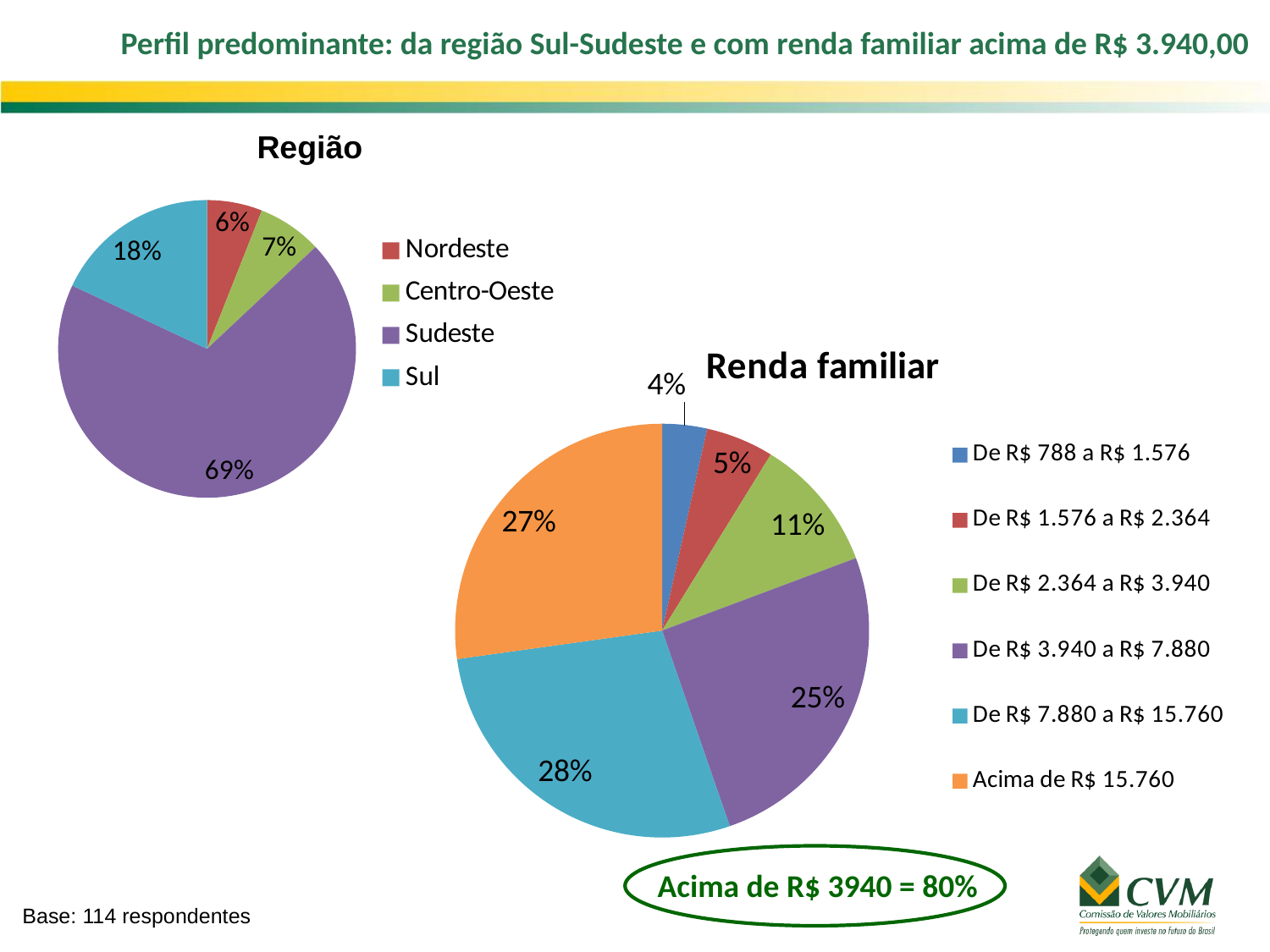
In the 'Renda familiar' pie chart, how many income brackets does the legend list? 6 In the 'Região' pie chart, what is the difference between the shares of Sudeste and Sul? 51% In the 'Renda familiar' pie chart, what is the share for 'De R$ 7.880 a R$ 15.760'? 28% In the 'Região' pie chart, what is the share for Sul? 18% What type of chart is the 'Renda familiar' chart? Pie chart In the 'Região' pie chart, which region has the smallest share? Nordeste In the 'Renda familiar' pie chart, which income bracket has the largest share? De R$ 7.880 a R$ 15.760 In the 'Renda familiar' pie chart, which is larger: 'De R$ 2.364 a R$ 3.940' or 'De R$ 3.940 a R$ 7.880'? De R$ 3.940 a R$ 7.880 In the 'Renda familiar' pie chart, what is the share for 'De R$ 788 a R$ 1.576'? 4% In the 'Região' pie chart, what is the share for Sudeste? 69% In the 'Região' pie chart, how many regions are shown? 4 In the 'Renda familiar' pie chart, what is the combined share of 'De R$ 1.576 a R$ 2.364' and 'De R$ 2.364 a R$ 3.940'? 16%